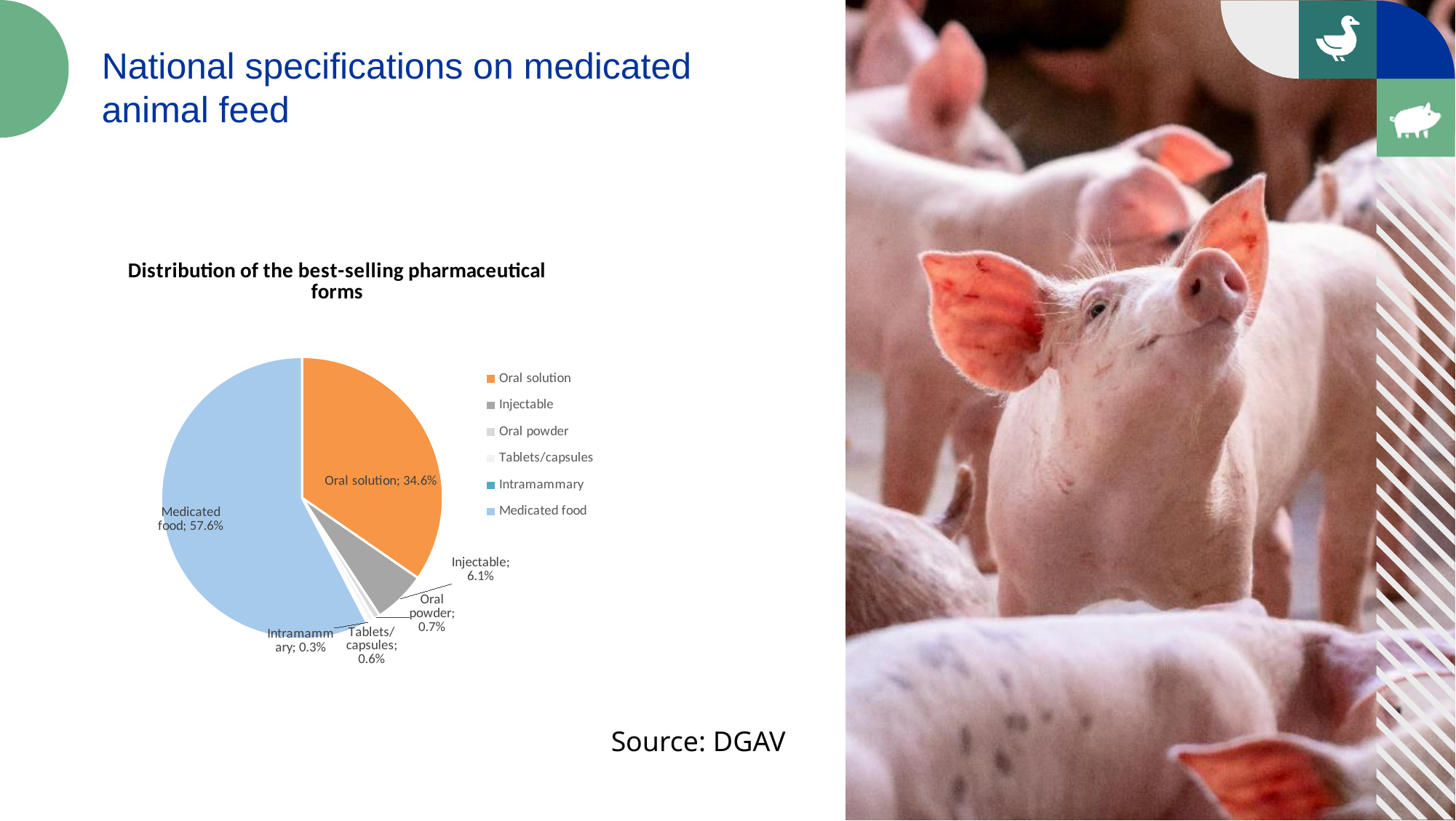
What type of chart is shown on the slide? pie chart What is the difference between the shares of Medicated food and Oral solution? 23.0% Which pharmaceutical form has the smallest share? Intramammary What is the value for Tablets/capsules? 0.6% What share of the pie does Oral solution have? 34.6% What is the title of the chart? Distribution of the best-selling pharmaceutical forms What is the value for Intramammary? 0.3% How many categories does the legend list? 6 What share of the pie does Medicated food have? 57.6% Which pharmaceutical form has the largest share? Medicated food What is the value for Oral powder? 0.7% What is the value for Injectable? 6.1%